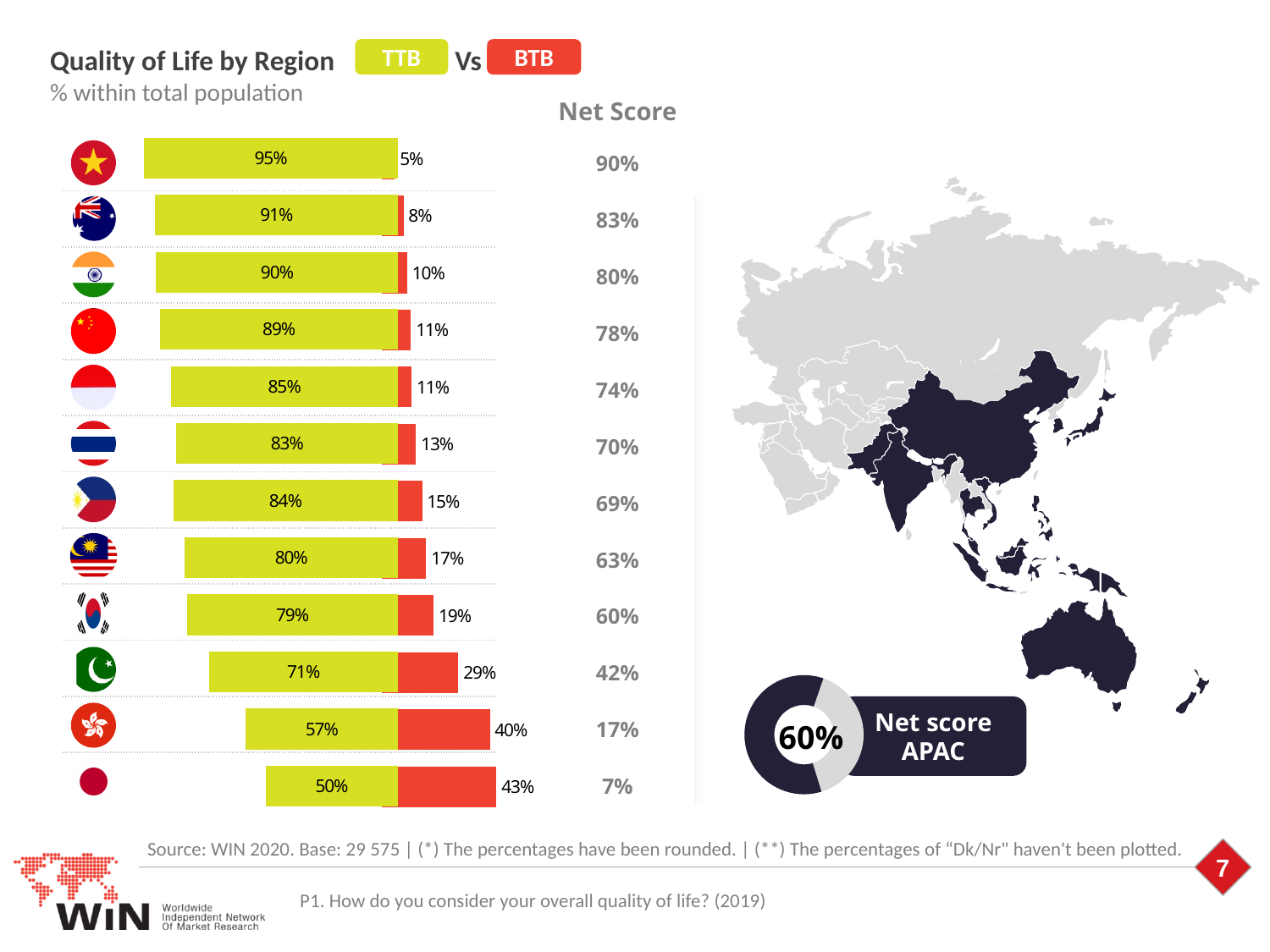
What is the highest TTB value shown in the Quality of Life by Region chart? 95% What is the TTB value for the top row of the Quality of Life by Region chart? 95% How many series does the legend of the Quality of Life by Region chart list? 2 What is the Net Score for the bottom row of the Quality of Life by Region chart? 7% How many rows (regions) are plotted in the Quality of Life by Region chart? 12 What is the lowest TTB value shown in the Quality of Life by Region chart? 50% Do the TTB values rise or fall going from the top row to the bottom row of the Quality of Life by Region chart? fall In the Quality of Life by Region chart, which has the larger BTB value: the row with 71% TTB or the row with 79% TTB? the row with 71% TTB What Net score for APAC is shown in the donut on the right of the slide? 60% What is the Net Score for the row whose TTB value is 71%? 42% What kind of chart is used to show Quality of Life by Region? bar chart What is the BTB value for the bottom row of the Quality of Life by Region chart? 43%